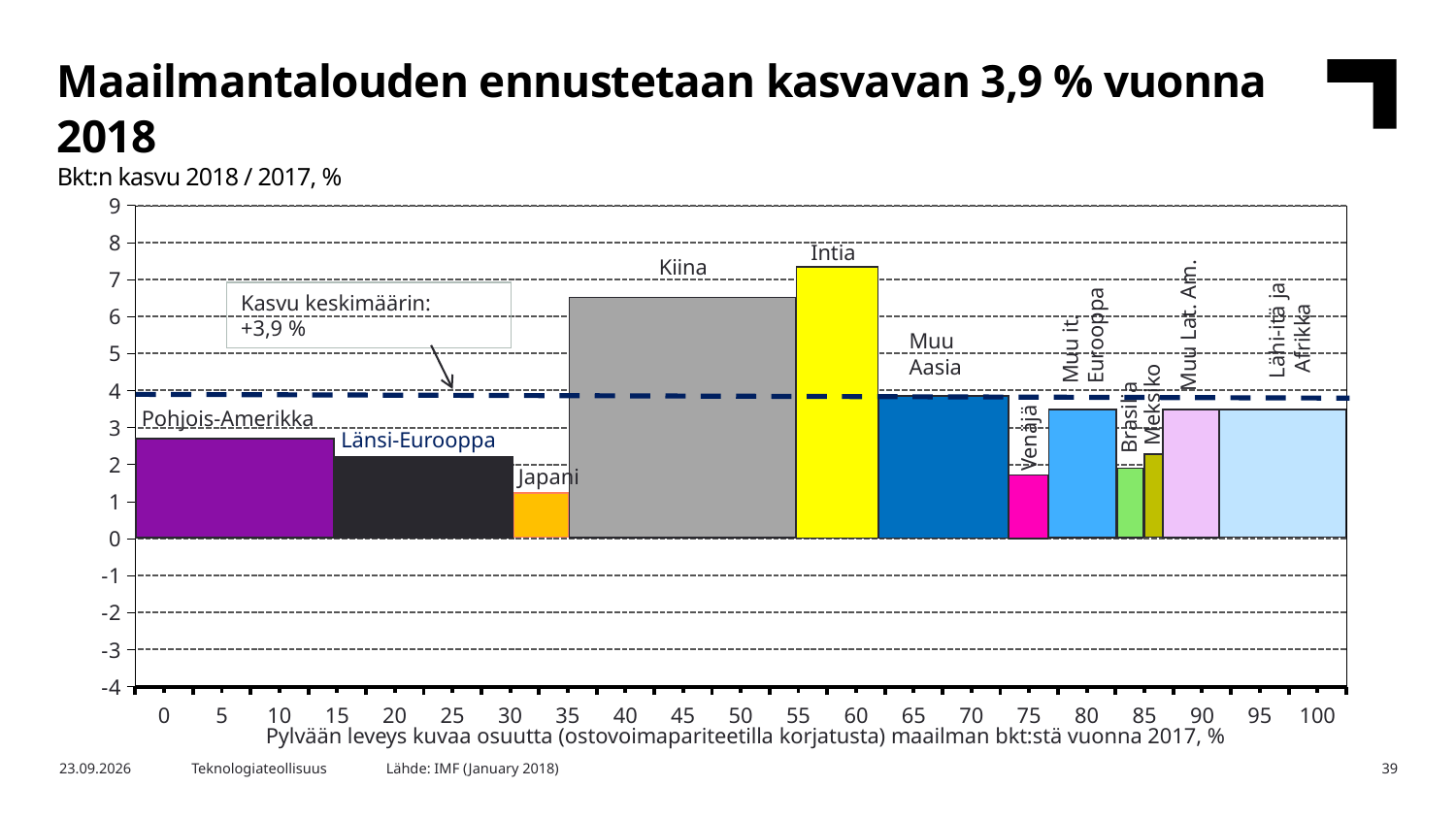
How many regions are shown as bars in the chart? 12 Is the value for Japani greater or less than 2? less What kind of chart is shown on the slide? bar chart Which has the higher growth forecast, Pohjois-Amerikka or Länsi-Eurooppa? Pohjois-Amerikka Is the value for Intia greater or less than 7? greater Which region has the highest GDP growth forecast in the chart? Intia According to the chart's subtitle, what does the chart measure? Bkt:n kasvu 2018 / 2017, % Is the value for Kiina greater or less than 6? greater Which has the higher growth forecast, Kiina or Intia? Intia Which region has the lowest GDP growth forecast in the chart? Japani What is the average growth (Kasvu keskimäärin) shown in the chart's annotation? +3,9 %